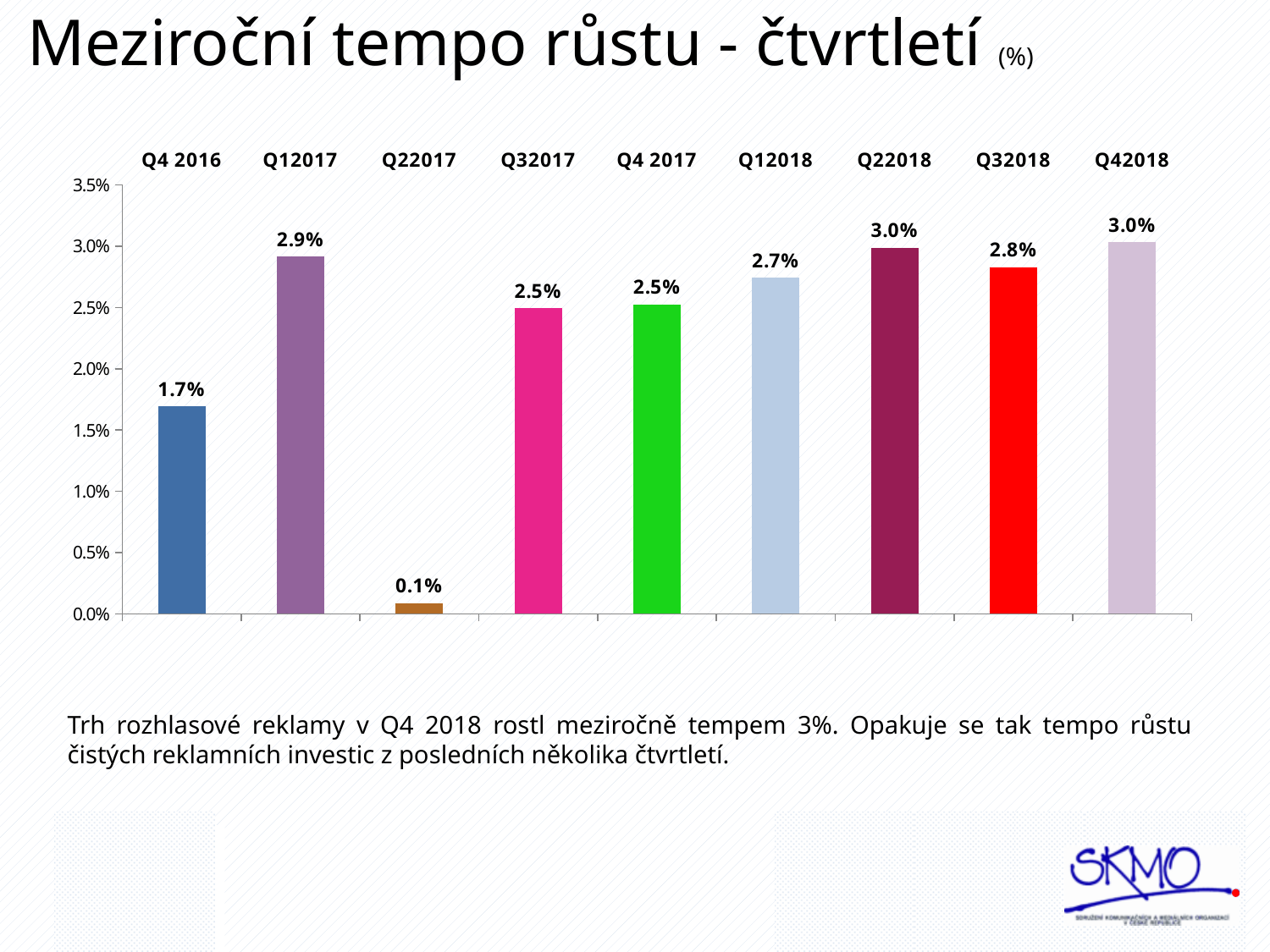
Do the values rise or fall from Q22017 to Q22018? rise Which is larger, the value for Q12017 or the value for Q12018? Q12017 What is the value for Q12018? 2.7% Which quarter has the lowest value? Q22017 What is the difference between the values for Q42018 and Q32018? 0.2 percentage points How many quarters are shown in the chart? 9 What is the value for Q32018? 2.8% Is the value for Q4 2016 greater or less than 2.0%? less What is the value for Q4 2016? 1.7% What is the value for Q22017? 0.1% What is the difference between the values for Q12017 and Q4 2016? 1.2 percentage points What kind of chart is shown on the slide? bar chart